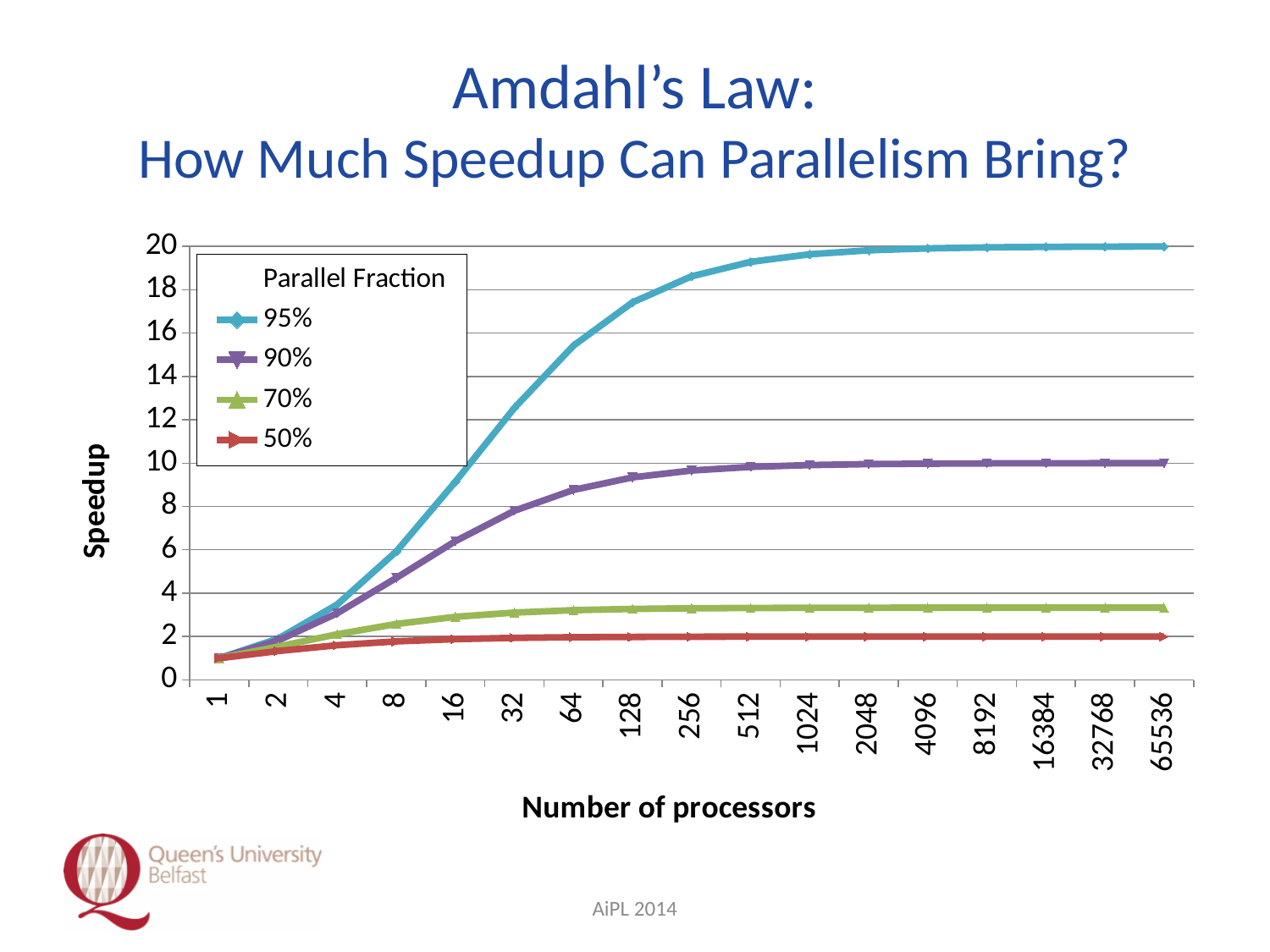
Is the speedup for the 90% series at 64 processors greater or less than 10? less Does the speedup for the 95% series rise or fall as the number of processors increases? rise At 128 processors, which series has the larger speedup, 90% or 70%? 90% What kind of chart is shown on the slide? line chart Is the speedup for the 70% series at 65536 processors greater or less than 4? less Is the speedup for the 50% series at 1024 processors greater or less than 4? less How many points are shown along the x axis (Number of processors)? 17 How many series does the legend list? 4 Which series has the lowest speedup at 65536 processors? 50% What is the title of the legend? Parallel Fraction Which series reaches the highest speedup? 95%